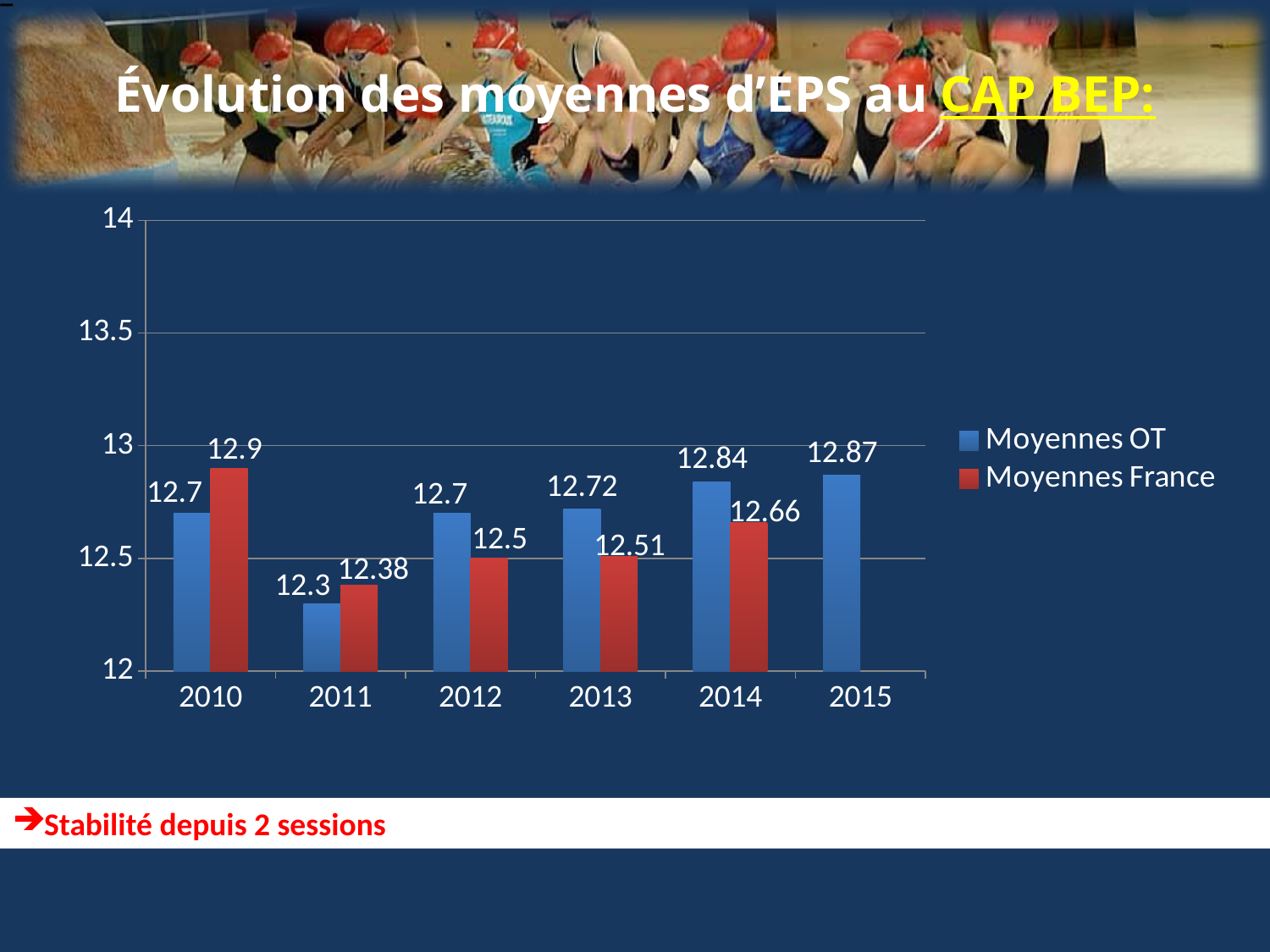
How many series does the legend list? 2 Which year has the lowest Moyennes OT value? 2011 In 2012, which is larger: Moyennes OT or Moyennes France? Moyennes OT What is the value of Moyennes OT for 2015? 12.87 How many years are shown on the x axis? 6 What is the difference between Moyennes France and Moyennes OT in 2014? 0.18 What is the value of Moyennes OT for 2013? 12.72 Is the Moyennes OT value for 2011 greater or less than 12.5? less Which colour represents Moyennes France in the chart? red Which year has the highest Moyennes France value? 2010 What kind of chart is shown on the slide? bar chart What is the value of Moyennes France for 2011? 12.38